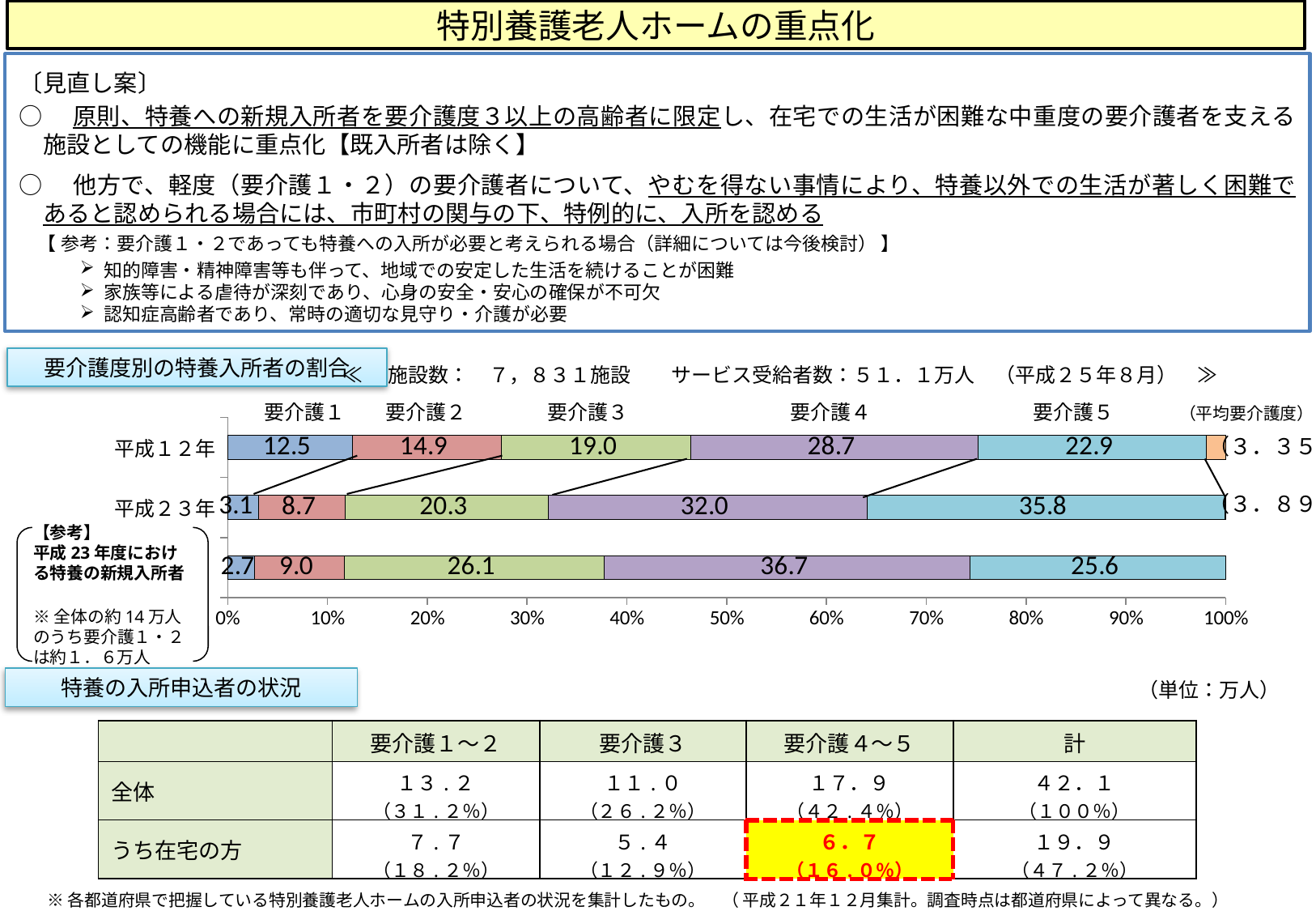
In the 要介護度別の特養入所者の割合 chart, how many care-level categories (要介護1 to 要介護5) are labelled above the bars? 5 In the 要介護度別の特養入所者の割合 chart, what is the value for 要介護4 in the bottom bar (平成23年度の新規入所者)? 36.7 In the 要介護度別の特養入所者の割合 chart, which care level has the largest share in the 平成12年 bar? 要介護4 In the 要介護度別の特養入所者の割合 chart, is the 要介護1 share larger in 平成12年 or in 平成23年? 平成12年 In the 要介護度別の特養入所者の割合 chart, how many bars are plotted? 3 In the 要介護度別の特養入所者の割合 chart, what is the value for 要介護3 in the 平成12年 bar? 19.0 In the 要介護度別の特養入所者の割合 chart, what is the value for 要介護5 in the 平成23年 bar? 35.8 In the 要介護度別の特養入所者の割合 chart, what is the 平均要介護度 shown for 平成23年? 3.89 In the 要介護度別の特養入所者の割合 chart, by how much did the 要介護5 share increase from 平成12年 to 平成23年? 12.9 What kind of chart is shown under the heading 要介護度別の特養入所者の割合? Stacked bar chart In the 要介護度別の特養入所者の割合 chart, which care level has the smallest share in the 平成12年 bar? 要介護1 In the 要介護度別の特養入所者の割合 chart, which care level has the largest share in the 平成23年 bar? 要介護5